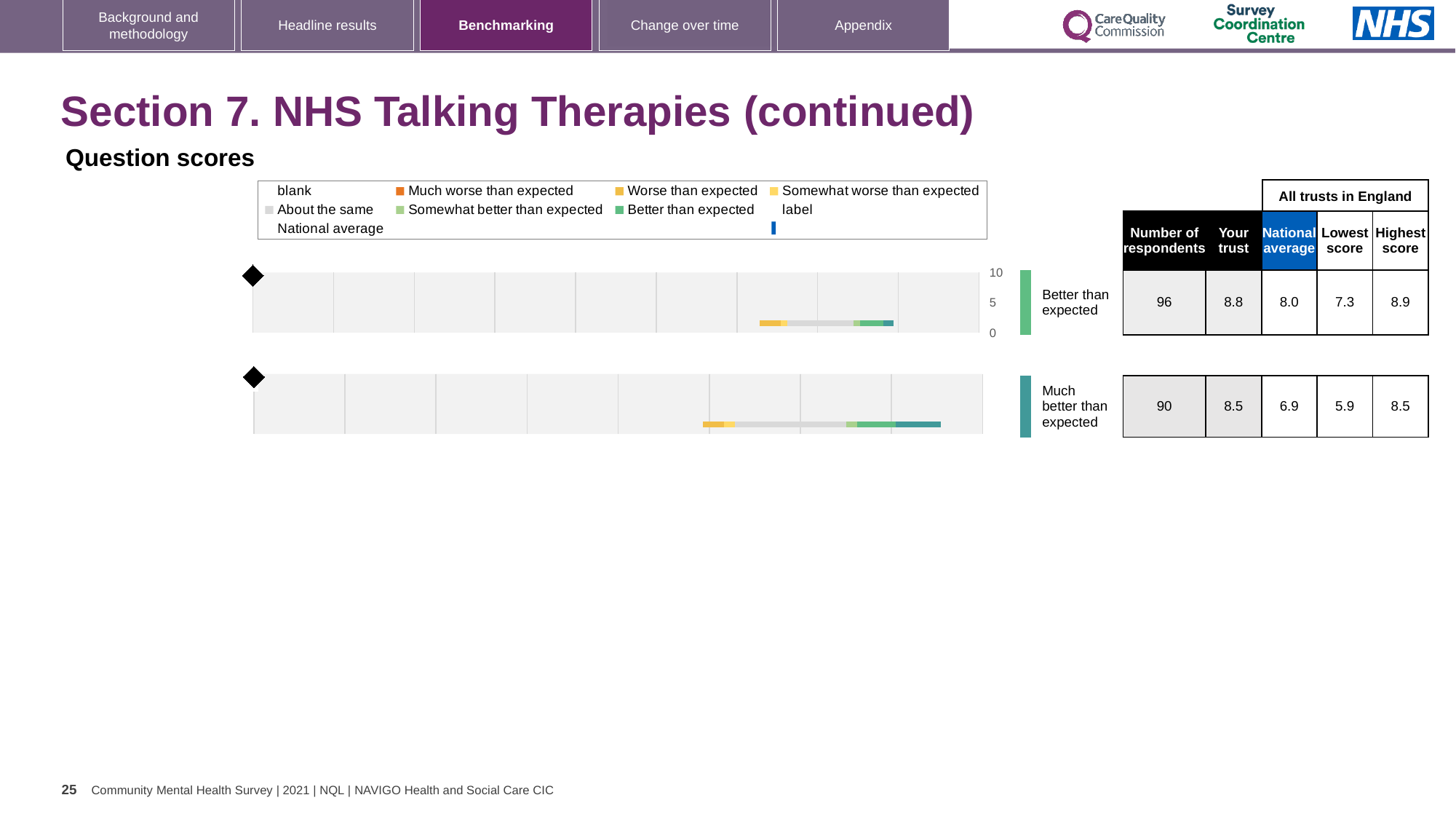
In the legend, what colour represents 'Much worse than expected'? orange What is the lowest score across all trusts in England for 'Much better than expected'? 5.9 In the table beside the bottom chart, what is the 'Your trust' score for 'Much better than expected'? 8.5 What is the highest tick value shown on the axis of the top chart? 10 Which has the higher 'Your trust' score: 'Better than expected' or 'Much better than expected'? Better than expected What kind of chart is used to show the question scores on this slide? bar chart What is the national average for 'Better than expected'? 8.0 What is the difference between the 'Your trust' score and the national average for 'Much better than expected'? 1.6 In the table beside the top chart, what is the 'Your trust' score for 'Better than expected'? 8.8 What is the number of respondents for 'Much better than expected'? 90 What is the national average for 'Much better than expected'? 6.9 How many benchmarking bar charts are shown on the slide? 2